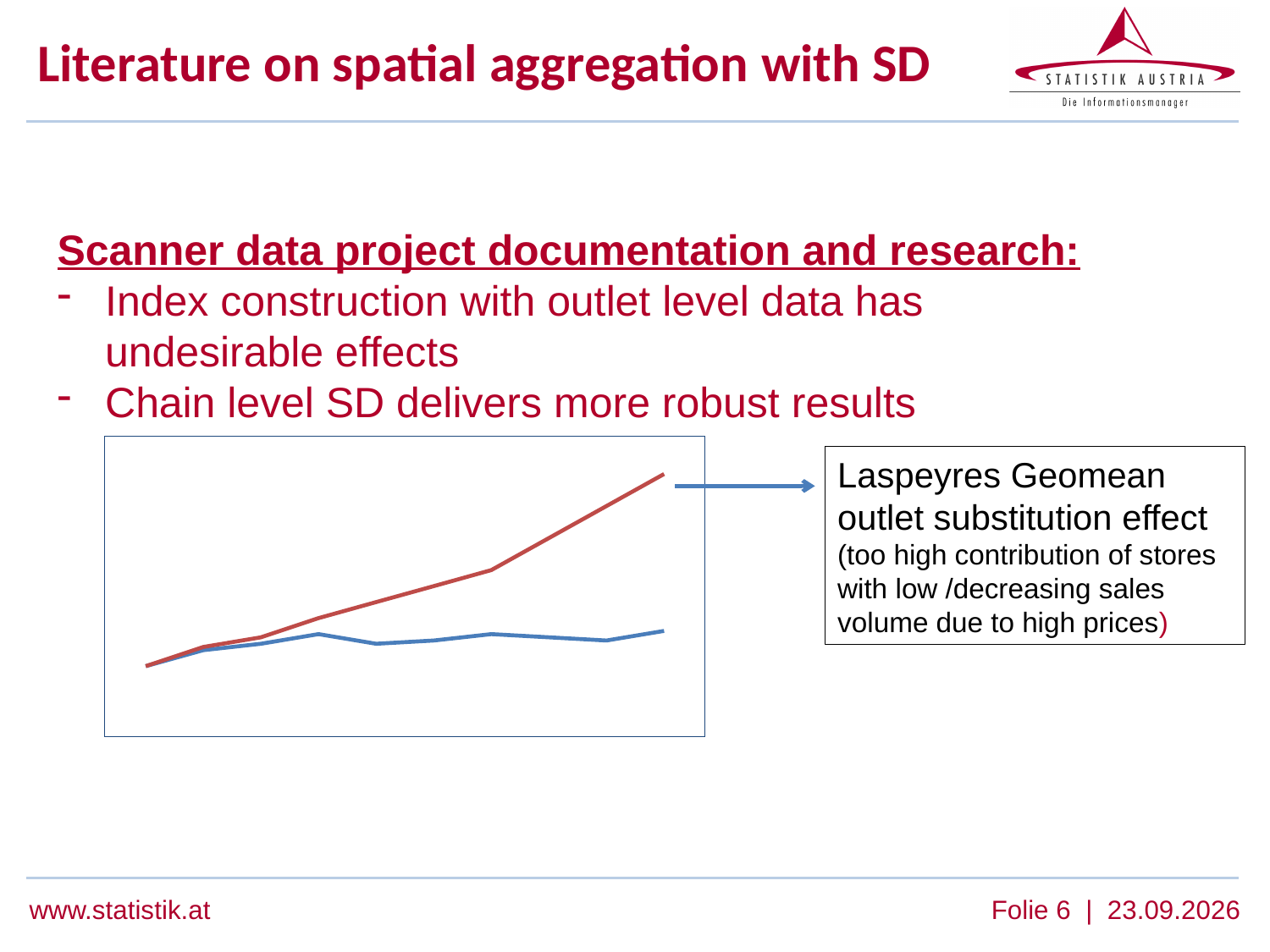
How many lines are plotted in the chart? 2 Do the red and blue lines start at the same point on the left of the chart? yes What kind of chart is shown on the slide? line chart Does the red line rise or fall from left to right? rise Which line is the arrow from the text box pointing to? the red line Does the gap between the red and blue lines widen or narrow from left to right? widen According to the annotation, which line shows the Laspeyres Geomean outlet substitution effect? the red line Which line ends higher at the right edge of the chart, the red line or the blue line? the red line